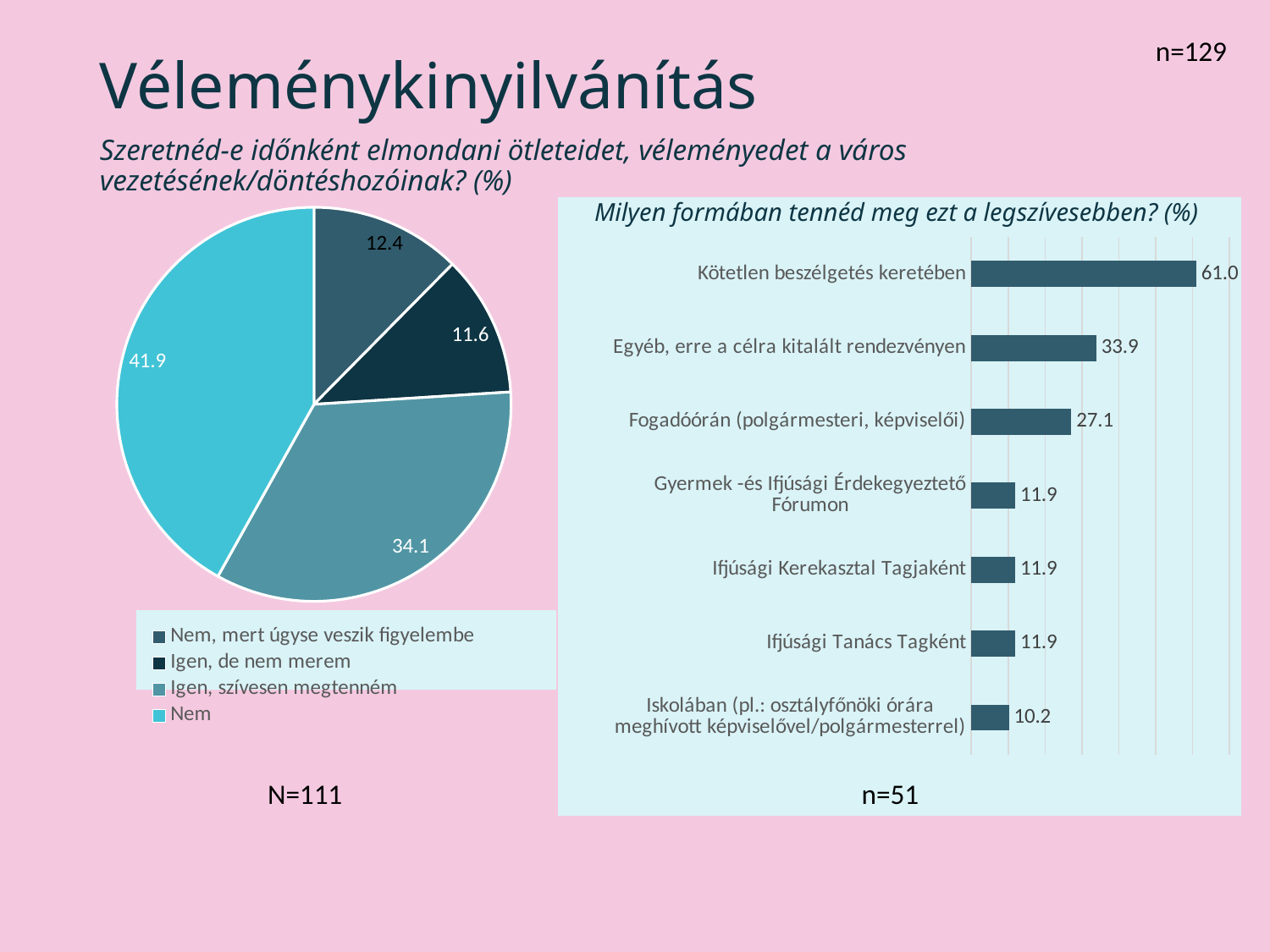
In the pie chart on the left, which category has the smallest slice? Igen, de nem merem In the bar chart on the right, what is the value for "Fogadóórán (polgármesteri, képviselői)"? 27.1 In the pie chart on the left, what is the value for "Igen, de nem merem"? 11.6 In the pie chart on the left, which category has the largest slice? Nem How many entries does the legend of the pie chart on the left list? 4 In the pie chart on the left, what is the value for "Nem"? 41.9 In the bar chart on the right, what is the difference between "Kötetlen beszélgetés keretében" and "Egyéb, erre a célra kitalált rendezvényen"? 27.1 In the bar chart on the right, which category has the highest value? Kötetlen beszélgetés keretében In the pie chart on the left, what is the difference between "Nem" and "Igen, szívesen megtenném"? 7.8 What kind of chart is the chart titled "Milyen formában tennéd meg ezt a legszívesebben? (%)"? bar chart How many categories are shown in the bar chart on the right? 7 In the bar chart on the right, which category has the lowest value? Iskolában (pl.: osztályfőnöki órára meghívott képviselővel/polgármesterrel)